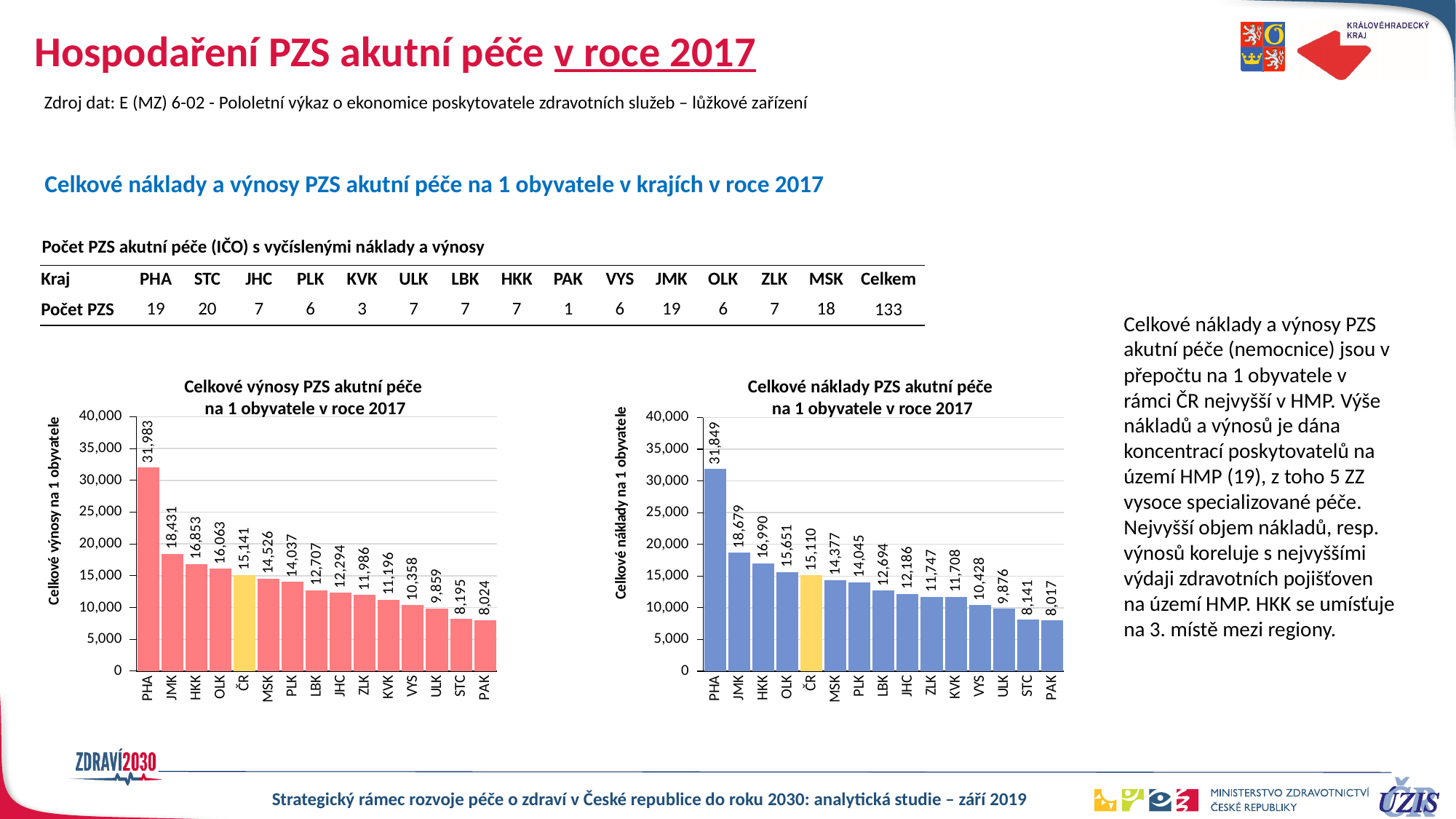
In the chart 'Celkové výnosy PZS akutní péče na 1 obyvatele v roce 2017', what is the value for HKK? 16,853 How many categories are shown in the chart 'Celkové náklady PZS akutní péče na 1 obyvatele v roce 2017'? 15 In the chart 'Celkové náklady PZS akutní péče na 1 obyvatele v roce 2017', what is the value for STC? 8,141 In the chart 'Celkové výnosy PZS akutní péče na 1 obyvatele v roce 2017', which category has the highest value? PHA In the chart 'Celkové náklady PZS akutní péče na 1 obyvatele v roce 2017', which category has the lowest value? PAK In the chart 'Celkové výnosy PZS akutní péče na 1 obyvatele v roce 2017', is the value for VYS greater or less than 15,000? less In the chart 'Celkové náklady PZS akutní péče na 1 obyvatele v roce 2017', what is the value for ČR? 15,110 In the chart 'Celkové náklady PZS akutní péče na 1 obyvatele v roce 2017', which is larger, the value for OLK or the value for MSK? OLK In the chart 'Celkové výnosy PZS akutní péče na 1 obyvatele v roce 2017', which bar is coloured yellow instead of red? ČR In the chart 'Celkové náklady PZS akutní péče na 1 obyvatele v roce 2017', do the values rise or fall from left to right along the x axis? fall In the chart 'Celkové výnosy PZS akutní péče na 1 obyvatele v roce 2017', what is the difference between the values for PHA and JMK? 13,552 What kind of chart is 'Celkové výnosy PZS akutní péče na 1 obyvatele v roce 2017'? bar chart